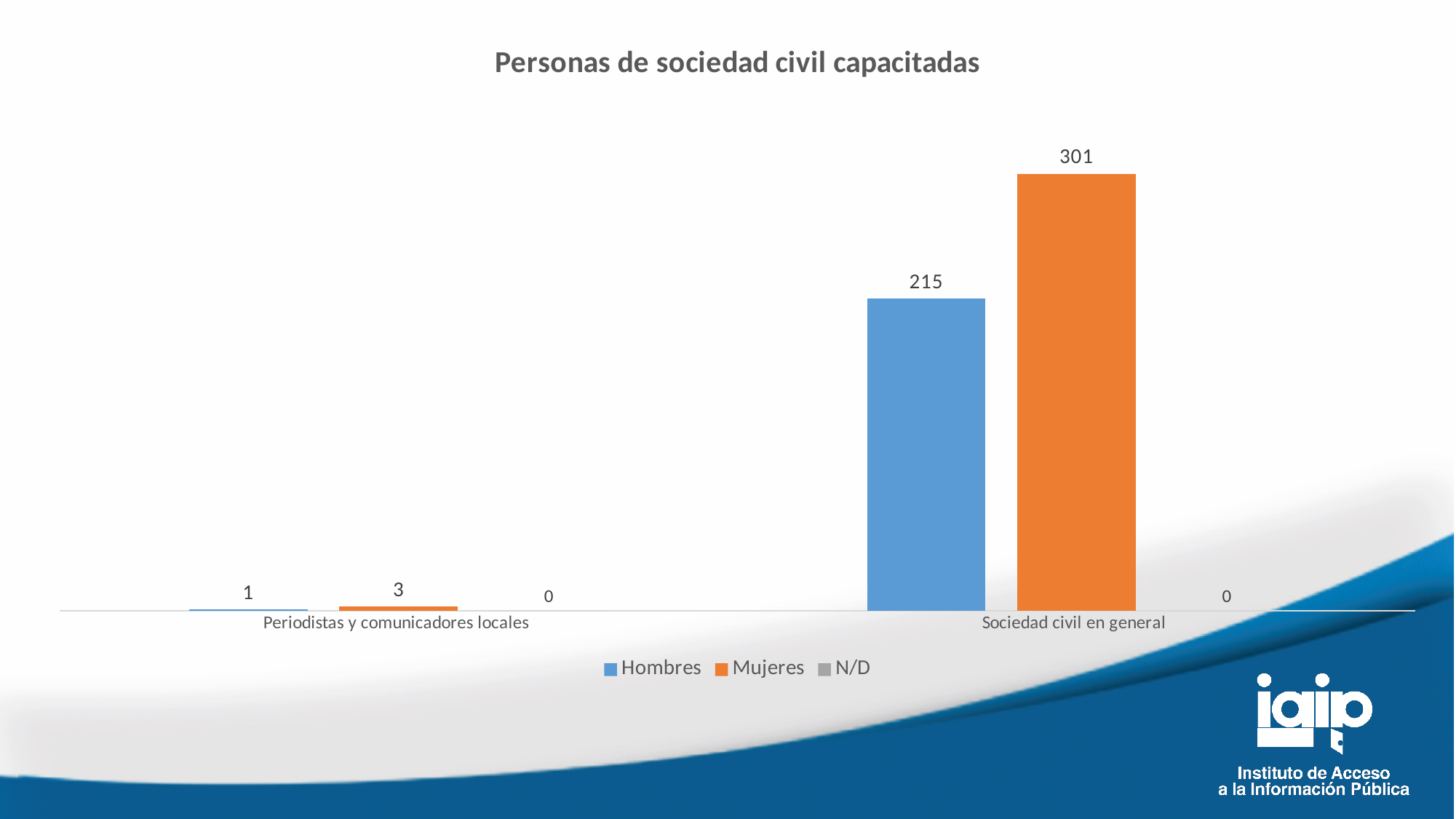
How many series does the legend list? 3 What is the value for Hombres in the Sociedad civil en general category? 215 How many categories are shown on the x axis? 2 What is the difference between Mujeres and Hombres in the Sociedad civil en general category? 86 What is the title of the chart? Personas de sociedad civil capacitadas What is the value for N/D in the Sociedad civil en general category? 0 What kind of chart is shown on the slide? Bar chart What is the value for Mujeres in the Sociedad civil en general category? 301 Which series has the highest value in the Sociedad civil en general category? Mujeres Which is larger in the Periodistas y comunicadores locales category, Hombres or Mujeres? Mujeres What is the value for Hombres in the Periodistas y comunicadores locales category? 1 What is the value for Mujeres in the Periodistas y comunicadores locales category? 3